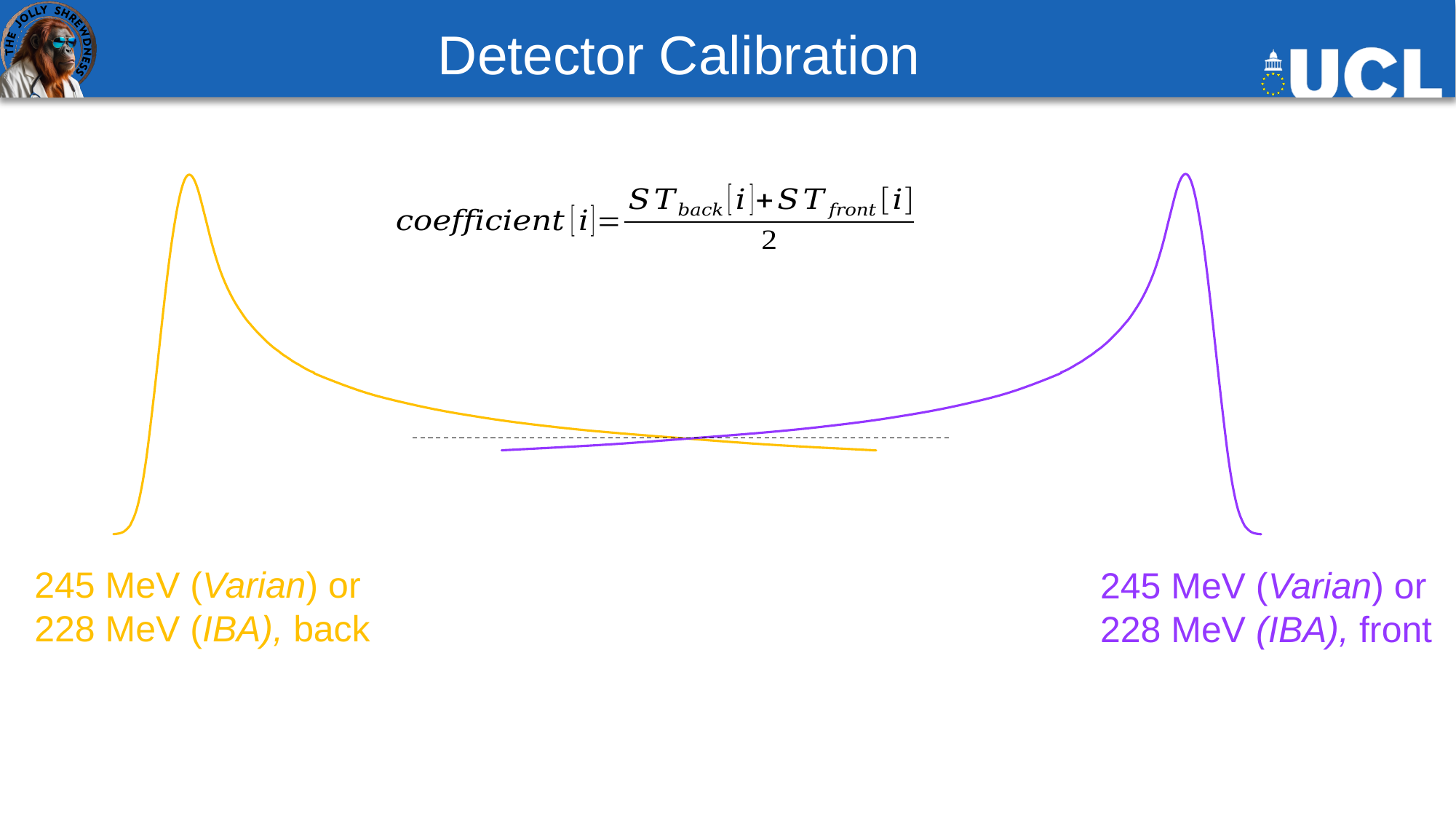
Does the purple (front) curve rise or fall from left to right before its peak? Rise On which side of the slide is the peak of the yellow (back) curve located? Left How many curves are drawn on the slide? 2 Does the yellow (back) curve rise or fall from left to right after its peak? Fall What colour is the curve labelled "245 MeV (Varian) or 228 MeV (IBA), back"? Yellow What colour is the curve labelled "245 MeV (Varian) or 228 MeV (IBA), front"? Purple